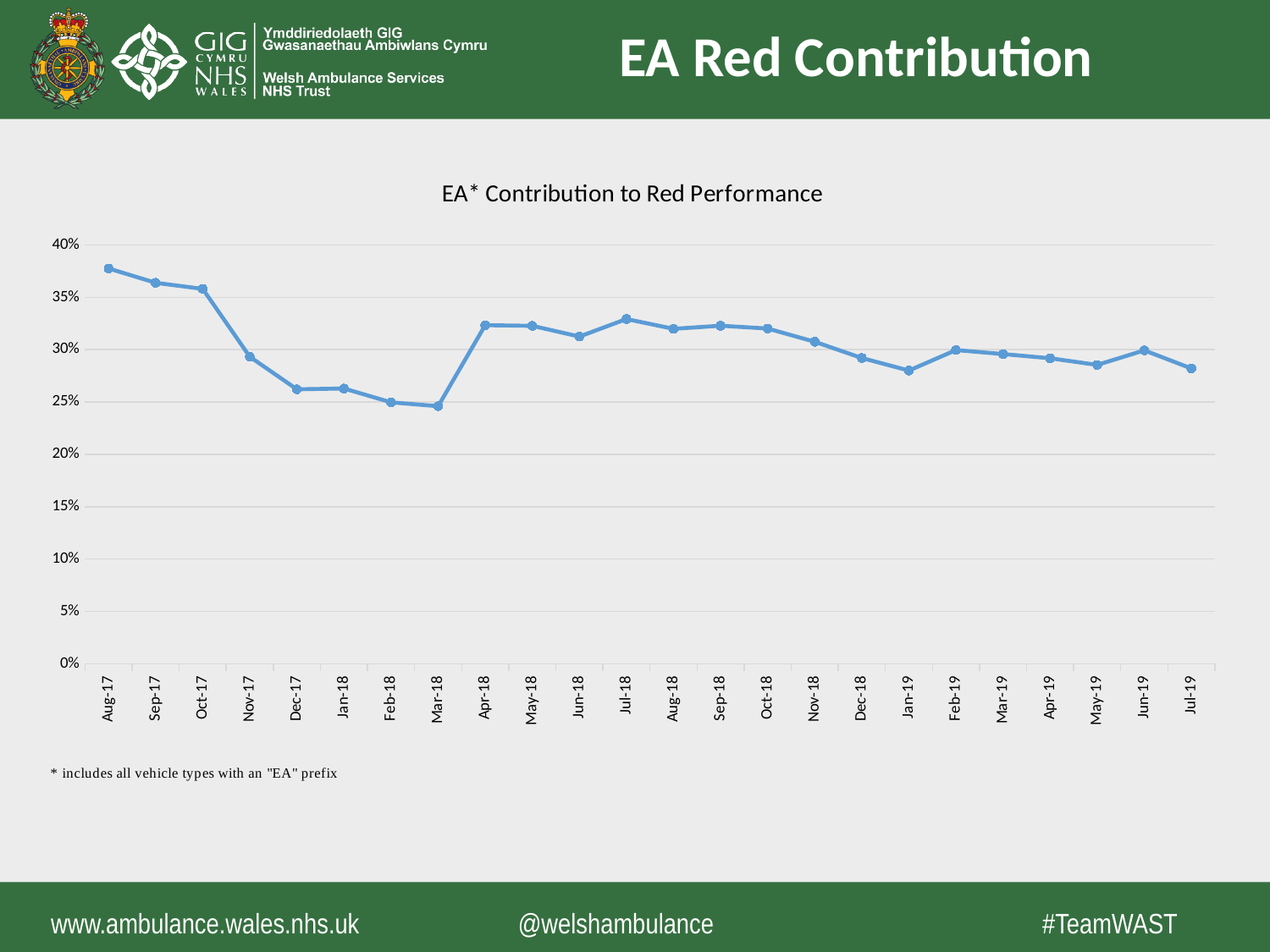
Is the value for Jul-18 greater or less than 30%? greater Which is larger, the value for Aug-17 or the value for Jul-19? Aug-17 What is the title of the chart? EA* Contribution to Red Performance Is the value for Aug-17 greater or less than 35%? greater Is the value for Jan-19 greater or less than 30%? less Do the values rise or fall from Aug-17 to Nov-17? fall What kind of chart is shown on the slide? Line chart What does the footnote below the chart say the asterisk in "EA*" means? includes all vehicle types with an "EA" prefix How many monthly data points are plotted on the chart? 24 Which month has the highest EA contribution to red performance? Aug-17 Which is larger, the value for Dec-17 or the value for Apr-18? Apr-18